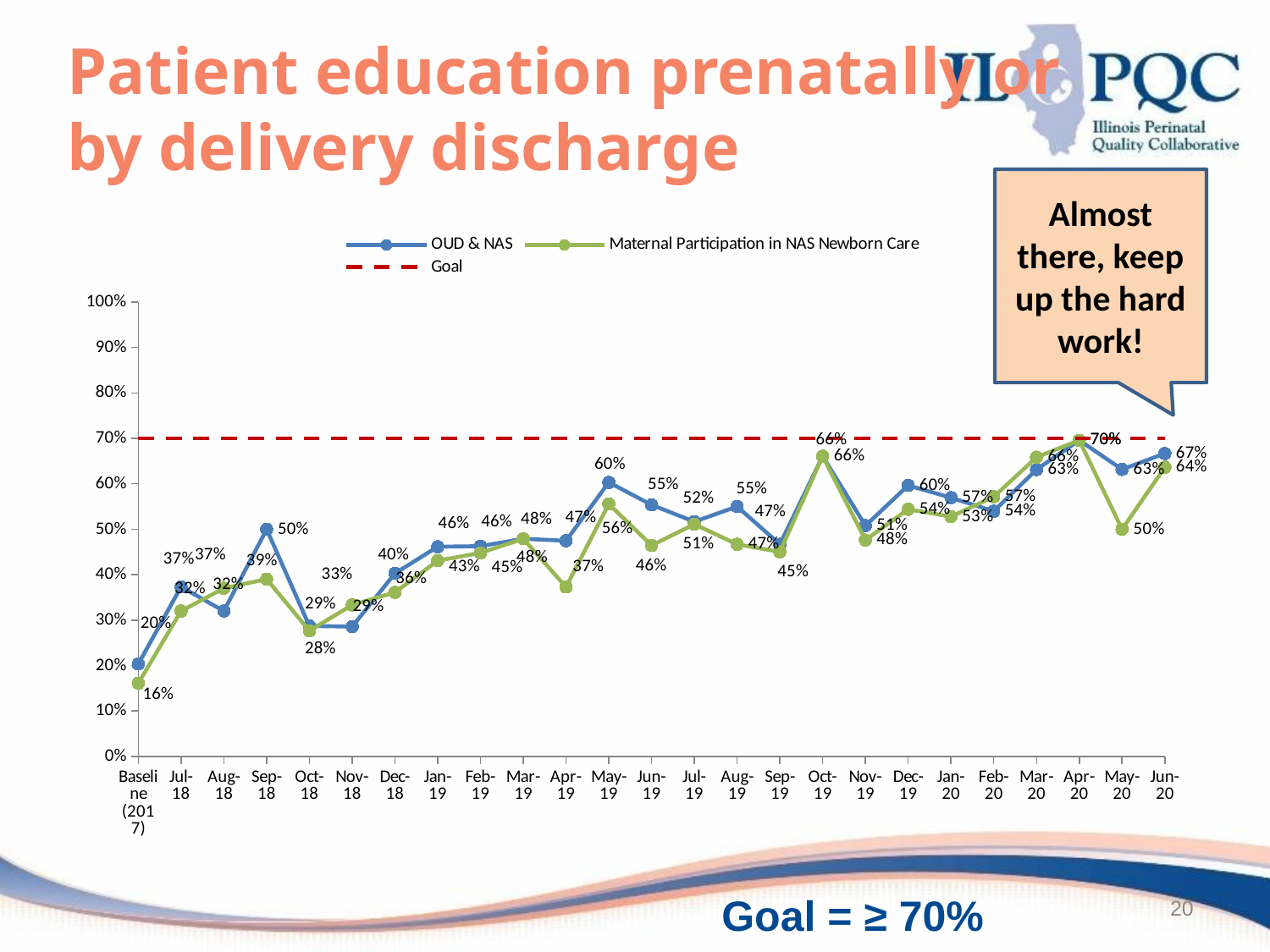
What is the Maternal Participation in NAS Newborn Care value at Baseline (2017)? 16% Overall, do the OUD & NAS values rise or fall from Baseline (2017) to Jun-20? Rise In May-20, which series has the higher value, OUD & NAS or Maternal Participation in NAS Newborn Care? OUD & NAS What is the OUD & NAS value at Baseline (2017)? 20% What is the difference between the OUD & NAS value and the Maternal Participation value in Jun-20? 3 percentage points How many series does the legend list? 3 In which month does the Maternal Participation in NAS Newborn Care series reach its highest value? Apr-20 What is the OUD & NAS value for Jun-20? 67% At what level is the Goal line drawn? 70% What type of chart is shown on the slide? Line chart What is the lowest value of the OUD & NAS series, and at which point does it occur? 20% at Baseline (2017) What is the Maternal Participation in NAS Newborn Care value for May-20? 50%